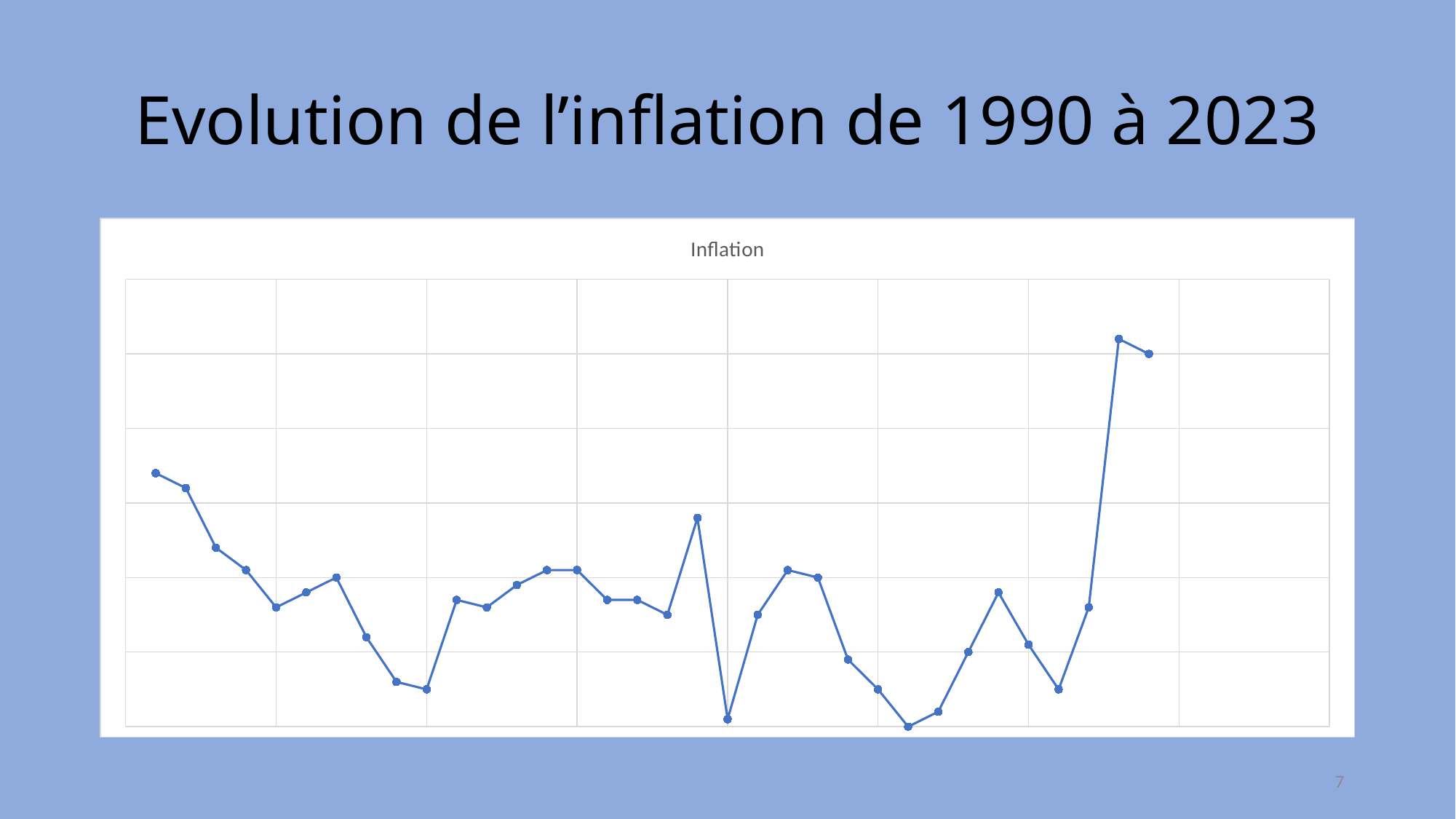
How many data points are plotted on the line? 34 Is the lowest point on the line in the left half or the right half of the chart? right half Is the second point on the line higher or lower than the first point? lower Is the last point on the line higher or lower than the point immediately before the sharp rise at the right end? higher Is the last point on the line higher or lower than the first point? higher What is the title printed above the chart? Inflation How many lines are plotted on the chart? 1 Which point on the line is the highest: the first, the last, or the second-to-last? the second-to-last Do the values rise or fall over the first five points of the line? fall What colour is the plotted line? blue What kind of chart is shown on the slide? line chart Between the second-to-last point and the last point, does the line rise or fall? fall